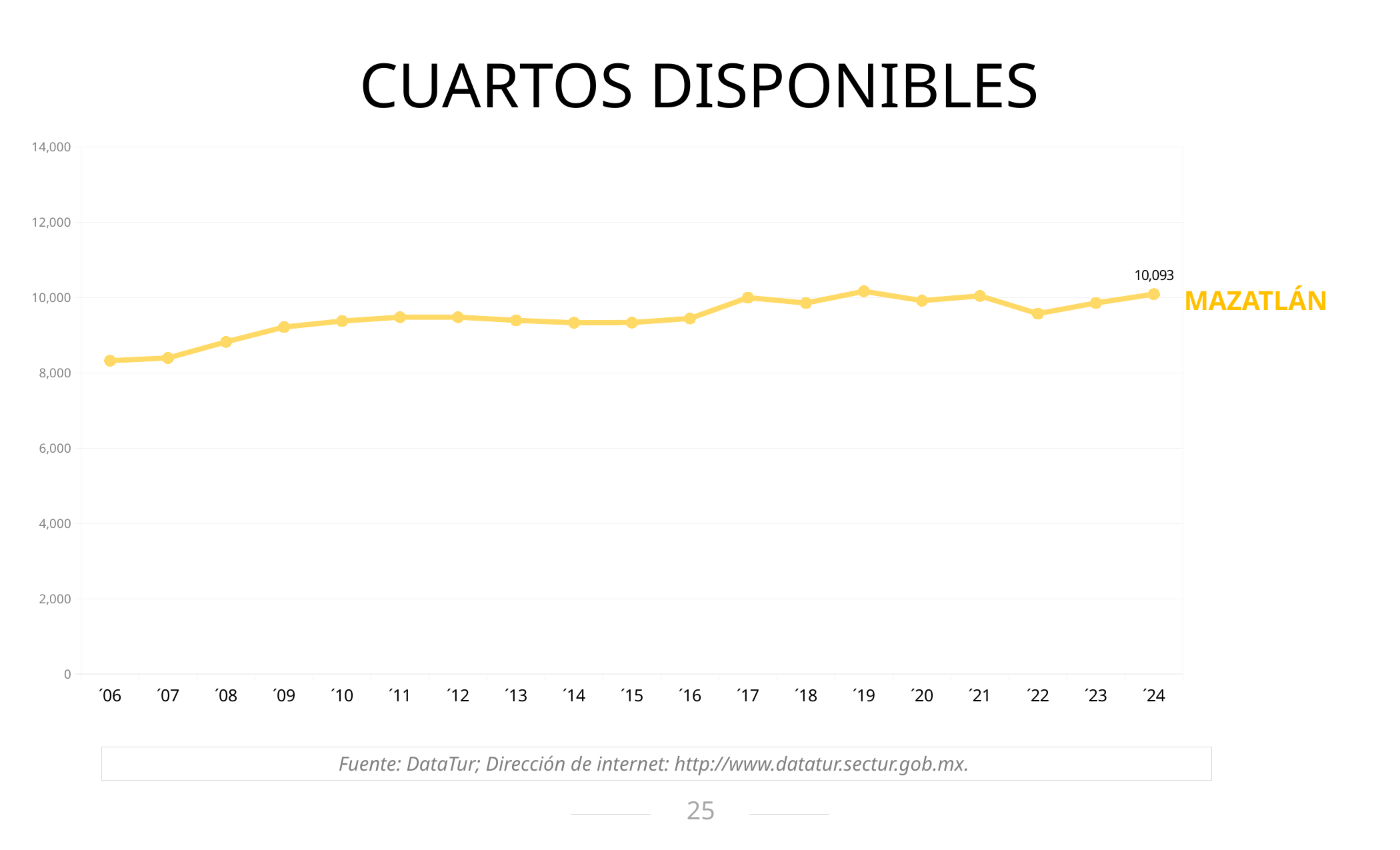
What is the value for ´24 on the CUARTOS DISPONIBLES chart? 10,093 What kind of chart is shown on the slide? Line chart Which is larger, the value for ´08 or the value for ´17? ´17 How many years (data points) are plotted on the x axis? 19 How many series are plotted on the chart? 1 Which is larger, the value for ´06 or the value for ´09? ´09 Overall, do the values rise or fall from ´06 to ´24? Rise Is the value for ´22 greater or less than 10,000? less Is the value for ´06 greater or less than 8,000? greater What is the name of the series labelled at the right end of the line? MAZATLÁN What is the title of the chart? CUARTOS DISPONIBLES Is the value for ´06 greater or less than 10,000? less